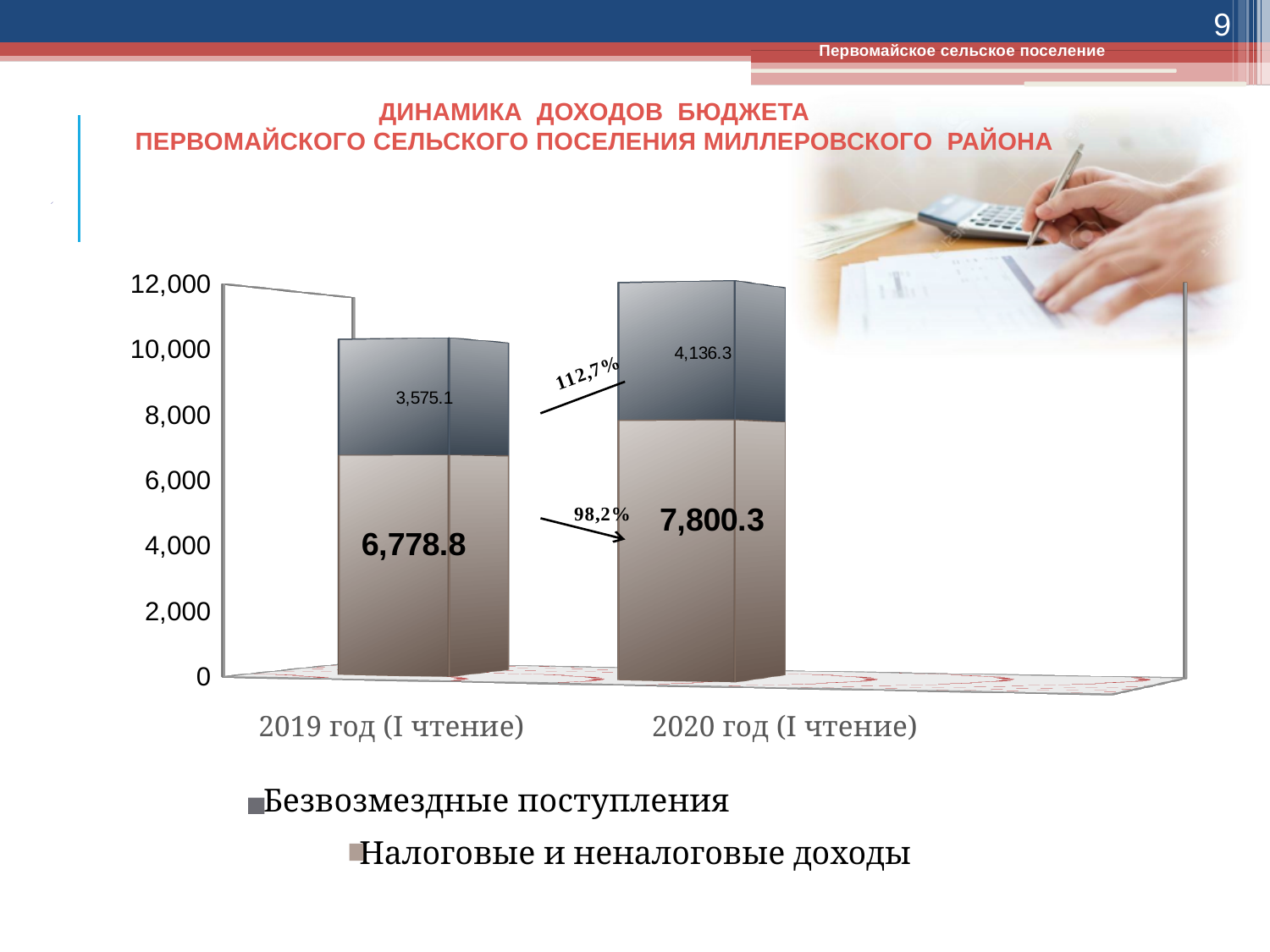
What is the total of the stacked bar for 2020 год (I чтение)? 11,936.6 What is the total of the stacked bar for 2019 год (I чтение)? 10,353.9 What is the value of Безвозмездные поступления for 2019 год (I чтение)? 3,575.1 How many categories are shown on the x axis? 2 What is the value of Налоговые и неналоговые доходы for 2019 год (I чтение)? 6,778.8 Is the value of Налоговые и неналоговые доходы for 2019 год (I чтение) larger or smaller than that for 2020 год (I чтение)? smaller Which year has the higher value of Безвозмездные поступления? 2020 год (I чтение) How many series does the legend list? 2 What is the value of Налоговые и неналоговые доходы for 2020 год (I чтение)? 7,800.3 What is the difference in Налоговые и неналоговые доходы between 2020 год (I чтение) and 2019 год (I чтение)? 1,021.5 What is the value of Безвозмездные поступления for 2020 год (I чтение)? 4,136.3 What kind of chart is shown on the slide? stacked bar chart